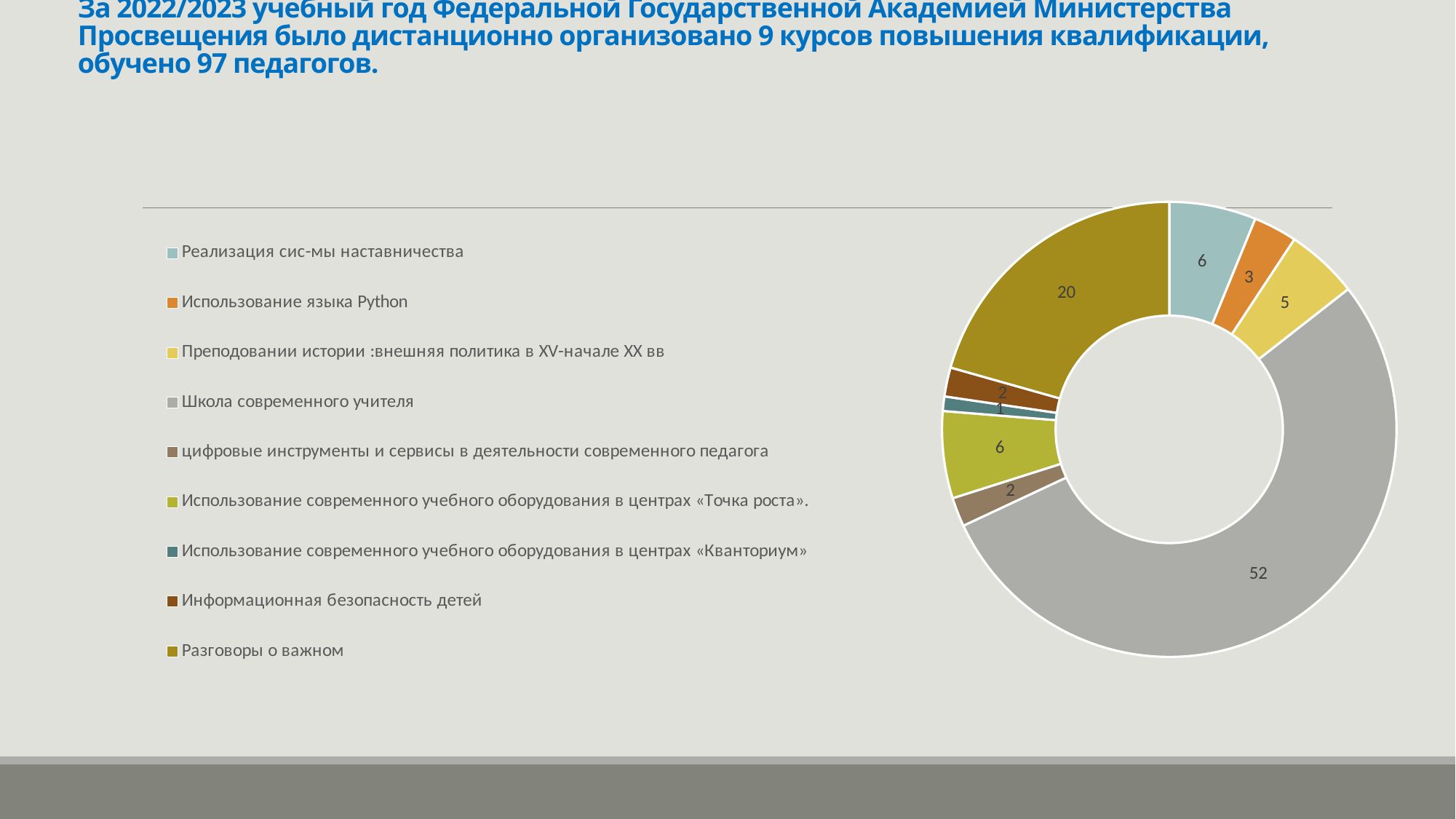
What is the total of all the values in the chart? 97 What is the value for «Использование языка Python»? 3 Which is larger: the value for «Преподовании истории :внешняя политика в XV-начале XX вв» or the value for «Реализация сис-мы наставничества»? Реализация сис-мы наставничества Which category has the largest value? Школа современного учителя What type of chart is shown on the slide? Doughnut (pie) chart What is the difference between the values for «Школа современного учителя» and «Разговоры о важном»? 32 Which category has the smallest value? Использование современного учебного оборудования в центрах «Кванториум» How many categories does the chart show? 9 What is the value for «Школа современного учителя»? 52 What is the value for «Использование современного учебного оборудования в центрах «Кванториум»»? 1 What is the value for «Разговоры о важном»? 20 What colour is the slice for «Школа современного учителя»? Grey